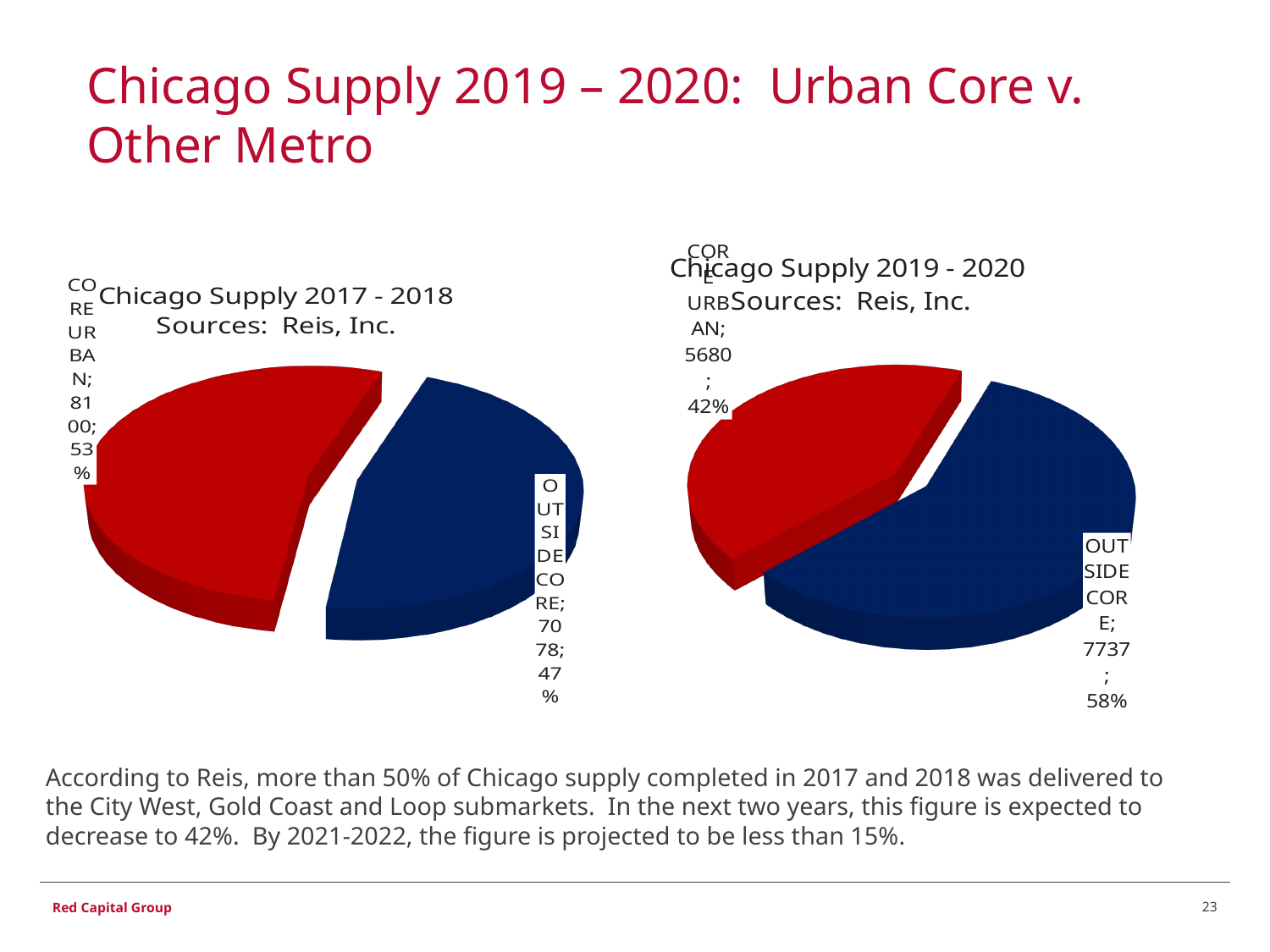
In the Chicago Supply 2017 - 2018 chart, what value is shown for CORE URBAN? 8100 In the Chicago Supply 2017 - 2018 chart, what share of the pie is OUTSIDE CORE? 47% How many slices does the Chicago Supply 2017 - 2018 chart have? 2 In the Chicago Supply 2019 - 2020 chart, what share of the pie is CORE URBAN? 42% What kind of chart is the Chicago Supply 2019 - 2020 chart? Pie chart In the Chicago Supply 2019 - 2020 chart, what colour is the OUTSIDE CORE slice? Dark blue In the Chicago Supply 2017 - 2018 chart, what is the difference between the CORE URBAN and OUTSIDE CORE values? 1022 In the Chicago Supply 2019 - 2020 chart, which slice is the largest? OUTSIDE CORE In the Chicago Supply 2019 - 2020 chart, what value is shown for OUTSIDE CORE? 7737 In the Chicago Supply 2019 - 2020 chart, what is the difference between the OUTSIDE CORE and CORE URBAN values? 2057 In the Chicago Supply 2017 - 2018 chart, which slice is the smallest? OUTSIDE CORE In the Chicago Supply 2019 - 2020 chart, which is larger, CORE URBAN or OUTSIDE CORE? OUTSIDE CORE